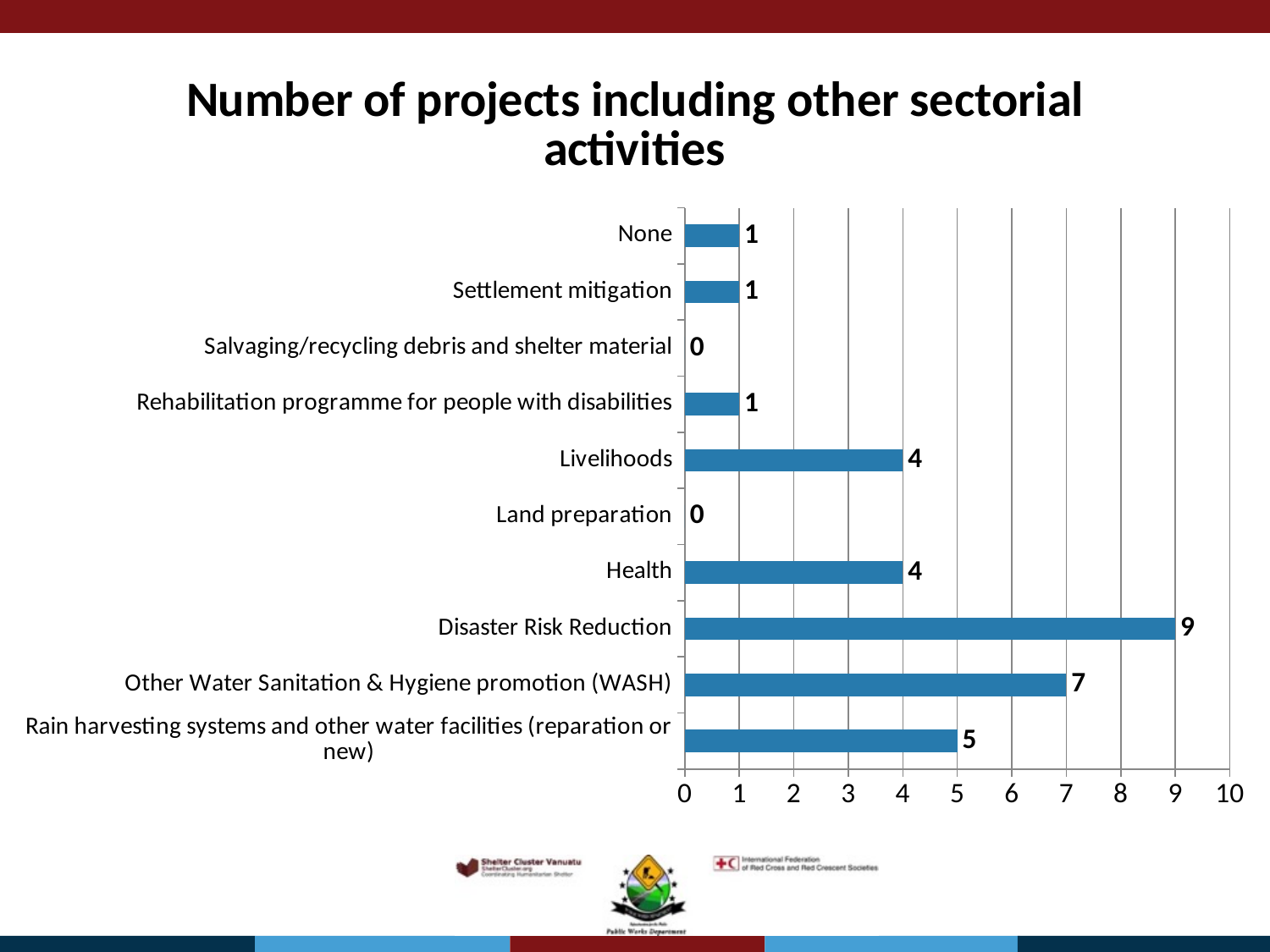
What is the number of projects for Rain harvesting systems and other water facilities (reparation or new)? 5 What is the title of the chart? Number of projects including other sectorial activities Which category has the highest number of projects? Disaster Risk Reduction Which has more projects, Other Water Sanitation & Hygiene promotion (WASH) or Rain harvesting systems and other water facilities (reparation or new)? Other Water Sanitation & Hygiene promotion (WASH) What is the number of projects for Livelihoods? 4 What kind of chart is shown on the slide? Bar chart How many categories are shown in the chart? 10 What is the maximum value shown on the horizontal axis? 10 How many categories have a value of 0? 2 What is the number of projects for Disaster Risk Reduction? 9 What is the number of projects for Other Water Sanitation & Hygiene promotion (WASH)? 7 What is the difference between the number of projects for Disaster Risk Reduction and for Health? 5